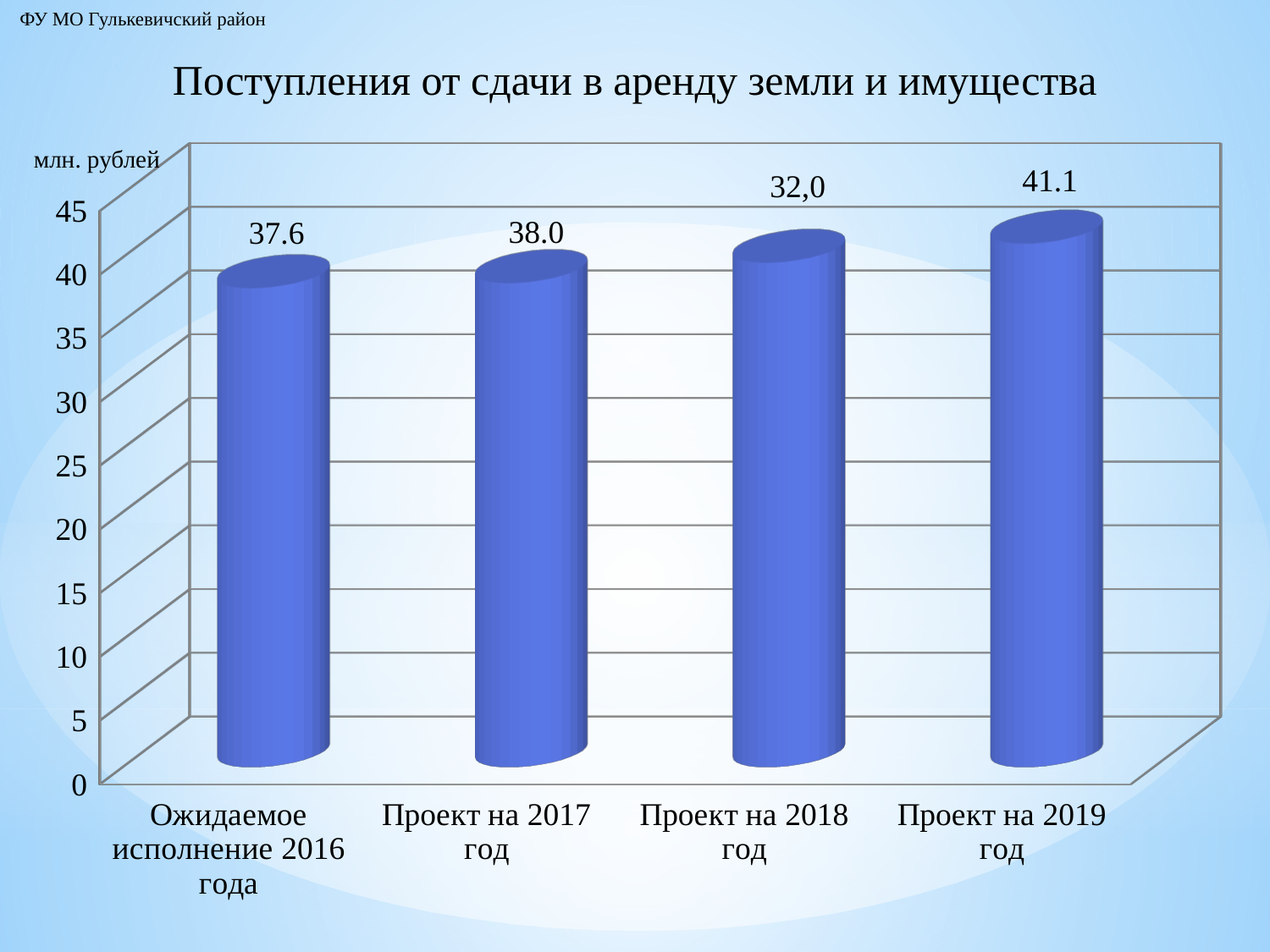
Which category has the highest value? Проект на 2019 год What is the value for «Ожидаемое исполнение 2016 года»? 37.6 What value is labelled on the bar for «Проект на 2018 год»? 32,0 Which is larger: the value for «Проект на 2019 год» or for «Ожидаемое исполнение 2016 года»? Проект на 2019 год What is the value for «Проект на 2017 год»? 38.0 What is the difference between the values for «Проект на 2017 год» and «Ожидаемое исполнение 2016 года»? 0.4 How many categories are shown on the x axis? 4 What is the difference between the values for «Проект на 2019 год» and «Проект на 2017 год»? 3.1 What unit of measurement is indicated on the chart? млн. рублей What is the value for «Проект на 2019 год»? 41.1 Is the value for «Проект на 2019 год» greater or less than 40? greater What kind of chart is shown on the slide? bar chart